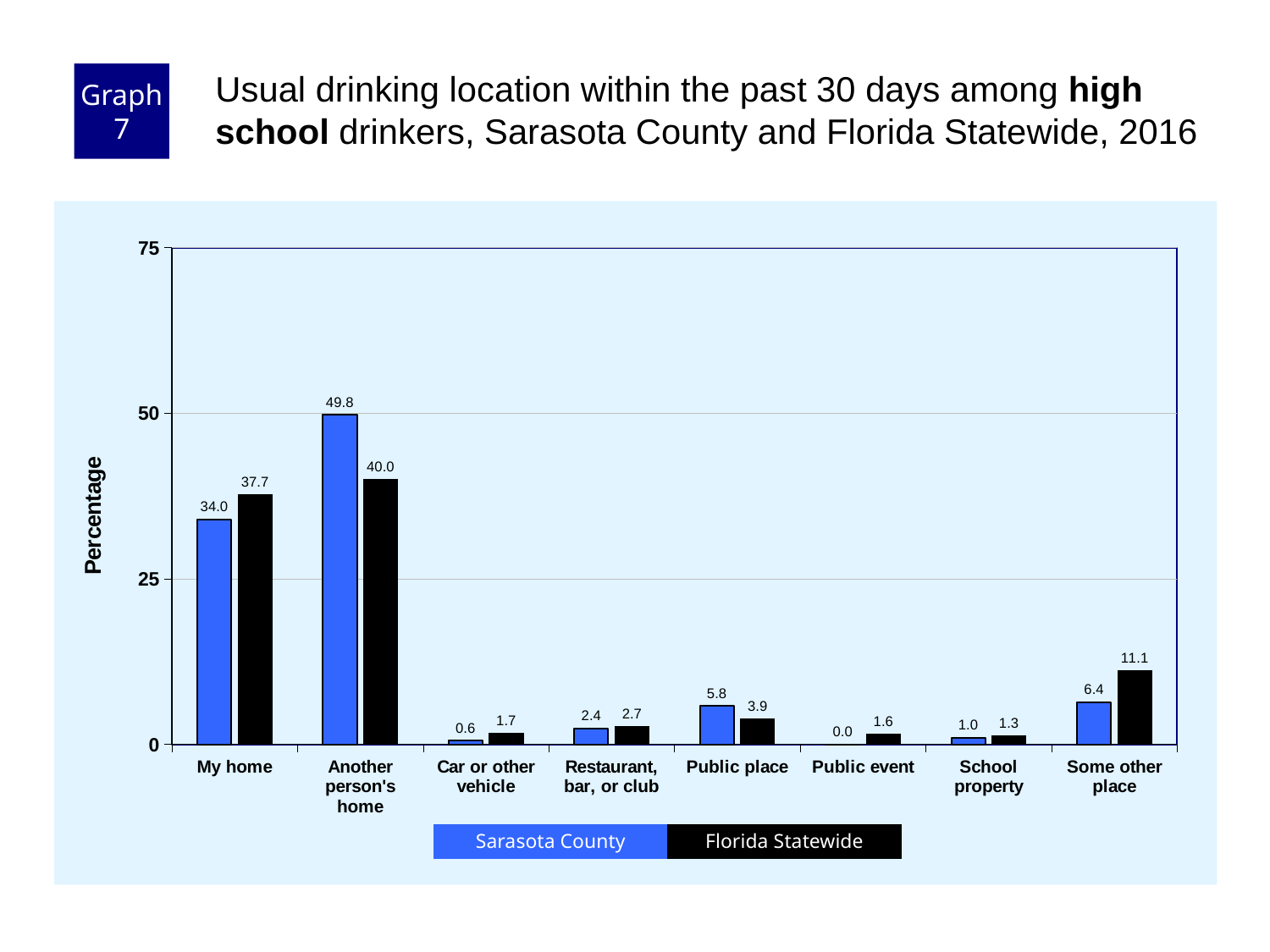
Which category has the highest Florida Statewide value? Another person's home What colour represents Sarasota County in the chart? Blue Is the Sarasota County value for "My home" greater or less than 25? greater What is the Florida Statewide value for "My home"? 37.7 What is the Sarasota County value for "Another person's home"? 49.8 What kind of chart is shown on the slide? Bar chart How many series does the legend list? 2 Which is larger for "Some other place": Sarasota County or Florida Statewide? Florida Statewide Which category has the lowest Sarasota County value? Public event How many location categories are shown on the x axis? 8 What is the difference between the Sarasota County and Florida Statewide values for "Another person's home"? 9.8 What is the Sarasota County value for "Public event"? 0.0